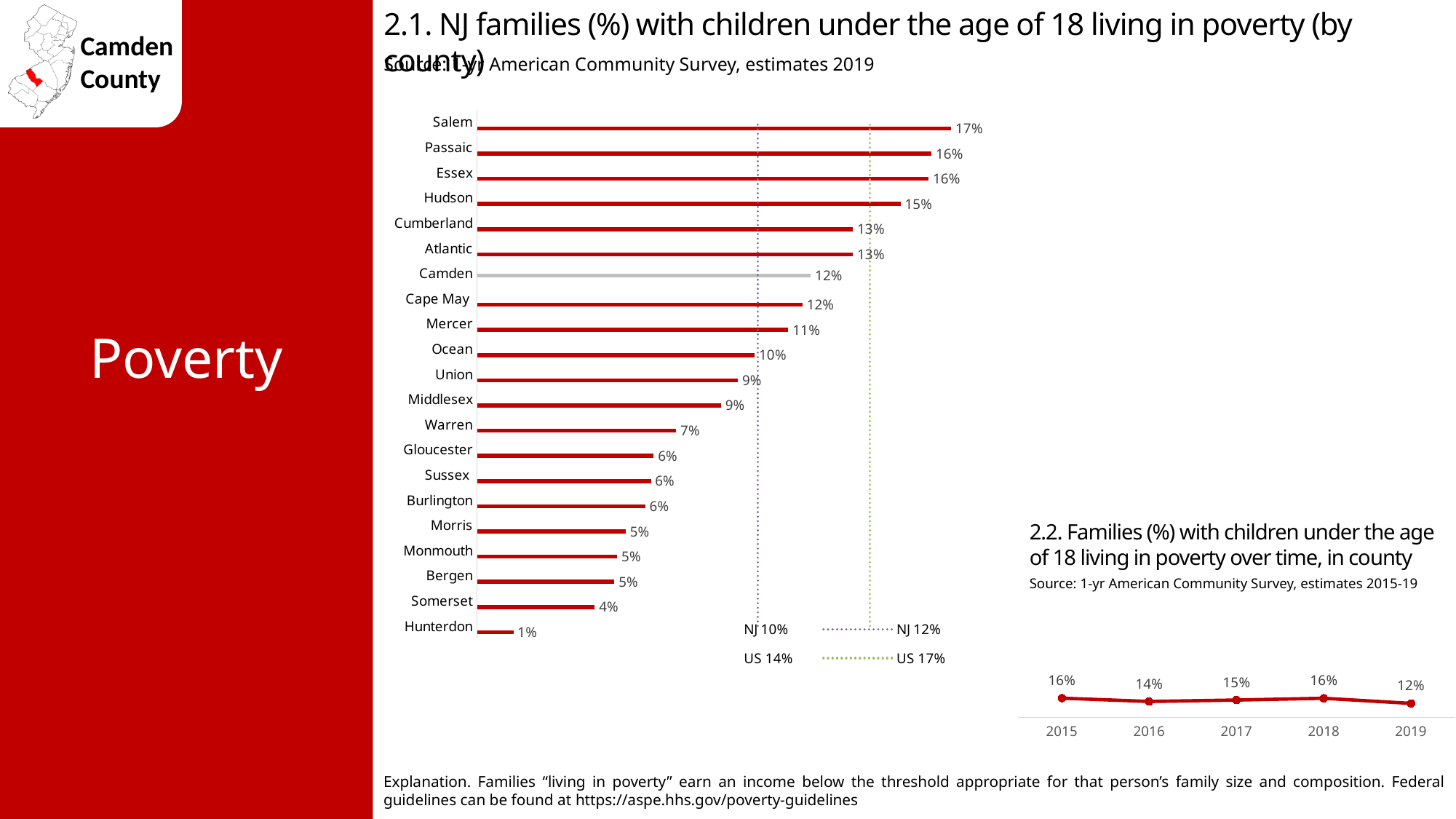
In chart 2.2 (over time, in county), what is the difference between 2018 and 2019? 4% In chart 2.2 (over time, in county), how many years are plotted? 5 In chart 2.1 (by county), what is the difference between Salem and Hunterdon? 16% In chart 2.1 (by county), how many counties are shown? 21 In chart 2.1 (by county), what is the value for Hudson? 15% In chart 2.2 (families in poverty over time, in county), what is the value for 2019? 12% In chart 2.1 (NJ families with children under 18 living in poverty by county), what is the value for Camden? 12% In chart 2.1 (by county), which is larger, the value for Mercer or the value for Warren? Mercer In chart 2.1 (by county), which bar is coloured grey instead of red? Camden In chart 2.1 (by county), which county has the highest percentage? Salem In chart 2.1 (by county), which county has the lowest percentage? Hunterdon What kind of chart is chart 2.1 (by county)? Bar chart